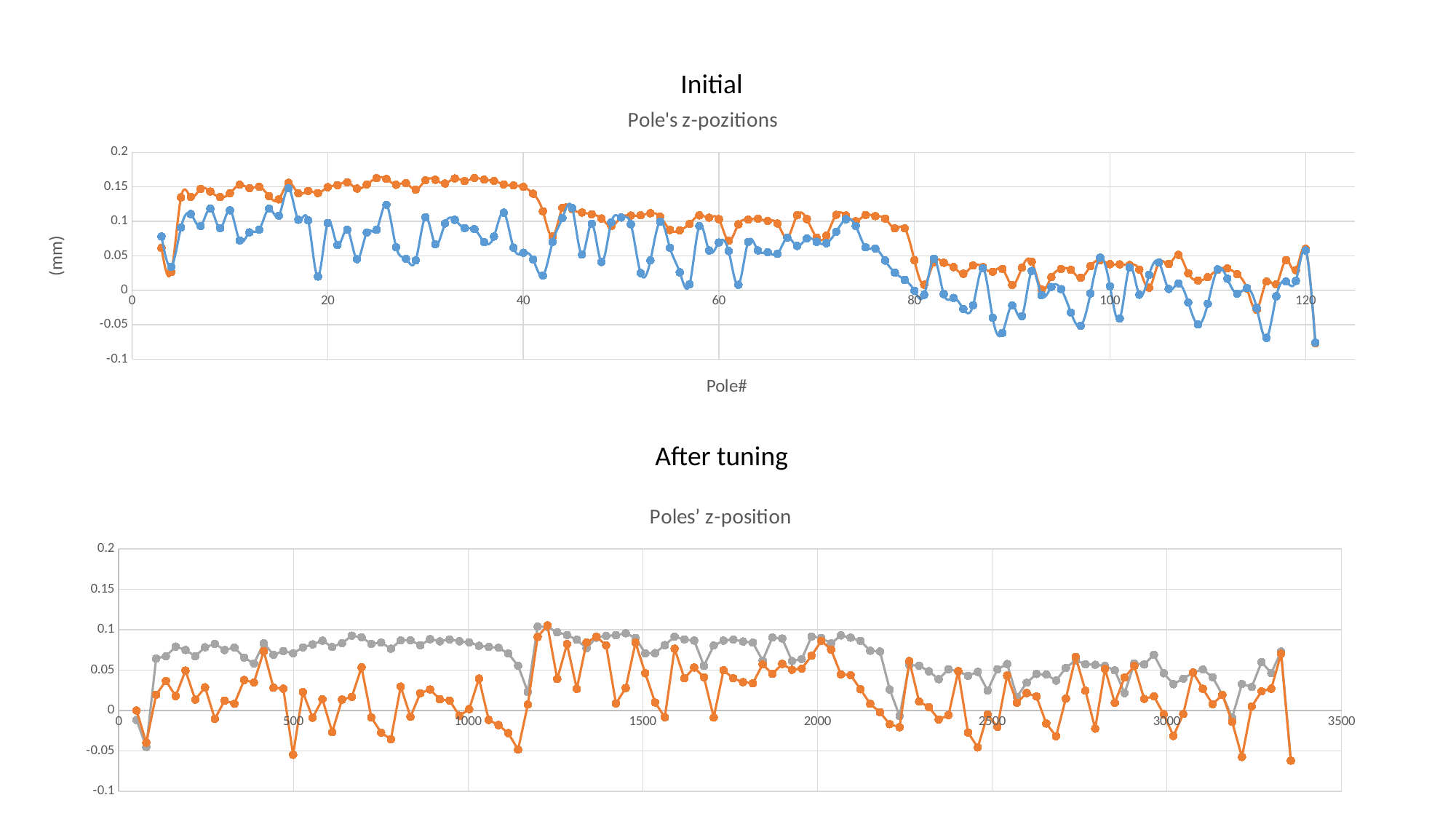
In the top chart (Initial), is the value of the orange series at pole 30 greater or less than 0.1? greater In the top chart (Initial), what is the label of the x axis? Pole# In the bottom chart (After tuning), at x = 1000, which series has the higher value, the grey or the orange? grey In the top chart (Initial), at pole 30, which series has the higher value, the orange or the blue? orange In the top chart (Initial), does the orange series generally rise or fall between pole 40 and pole 120? fall In the top chart (Initial), is the value of the orange series at pole 100 greater or less than 0.1? less In the top chart (Initial), what is the label of the y axis? (mm) What type of chart is the top chart titled "Pole's z-pozitions"? line chart In the bottom chart (After tuning), is the value of the orange series at x = 500 greater or less than 0? less How many data series are plotted in the bottom chart (After tuning)? 2 What type of chart is the bottom chart titled "Poles' z-position"? line chart